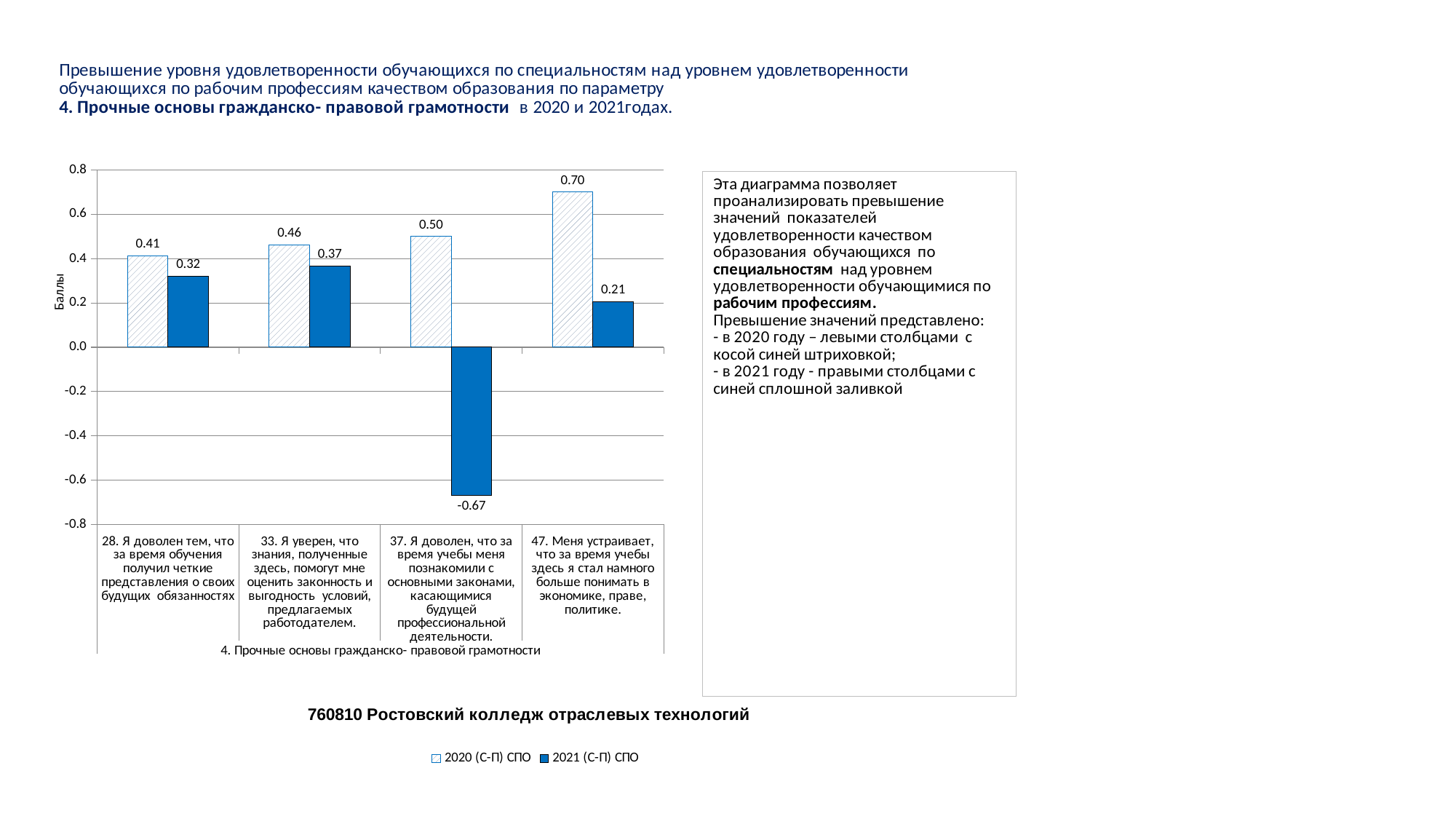
What type of chart is shown on the slide? Bar chart What is the difference between the 2020 (С-П) СПО and 2021 (С-П) СПО values for category 33? 0.09 How many series does the chart legend list? 2 Which category has the highest value in the 2020 (С-П) СПО series? 47. Меня устраивает, что за время учебы здесь я стал намного больше понимать в экономике, праве, политике. What is the value for the 2021 (С-П) СПО series for category 37 (Я доволен, что за время учебы меня познакомили с основными законами...)? -0.67 How many categories are shown on the x axis of the chart? 4 Is the 2020 (С-П) СПО value for category 37 greater or less than 0.4? greater For category 28, which series has the larger value: 2020 (С-П) СПО or 2021 (С-П) СПО? 2020 (С-П) СПО What is the difference between the 2020 (С-П) СПО and 2021 (С-П) СПО values for category 47? 0.49 Which category has the lowest value in the 2021 (С-П) СПО series? 37. Я доволен, что за время учебы меня познакомили с основными законами, касающимися будущей профессиональной деятельности. What is the value for the 2021 (С-П) СПО series for category 28 (Я доволен тем, что за время обучения получил четкие представления о своих будущих обязанностях)? 0.32 What is the value for the 2020 (С-П) СПО series for category 47 (Меня устраивает, что за время учебы здесь я стал намного больше понимать в экономике, праве, политике)? 0.70